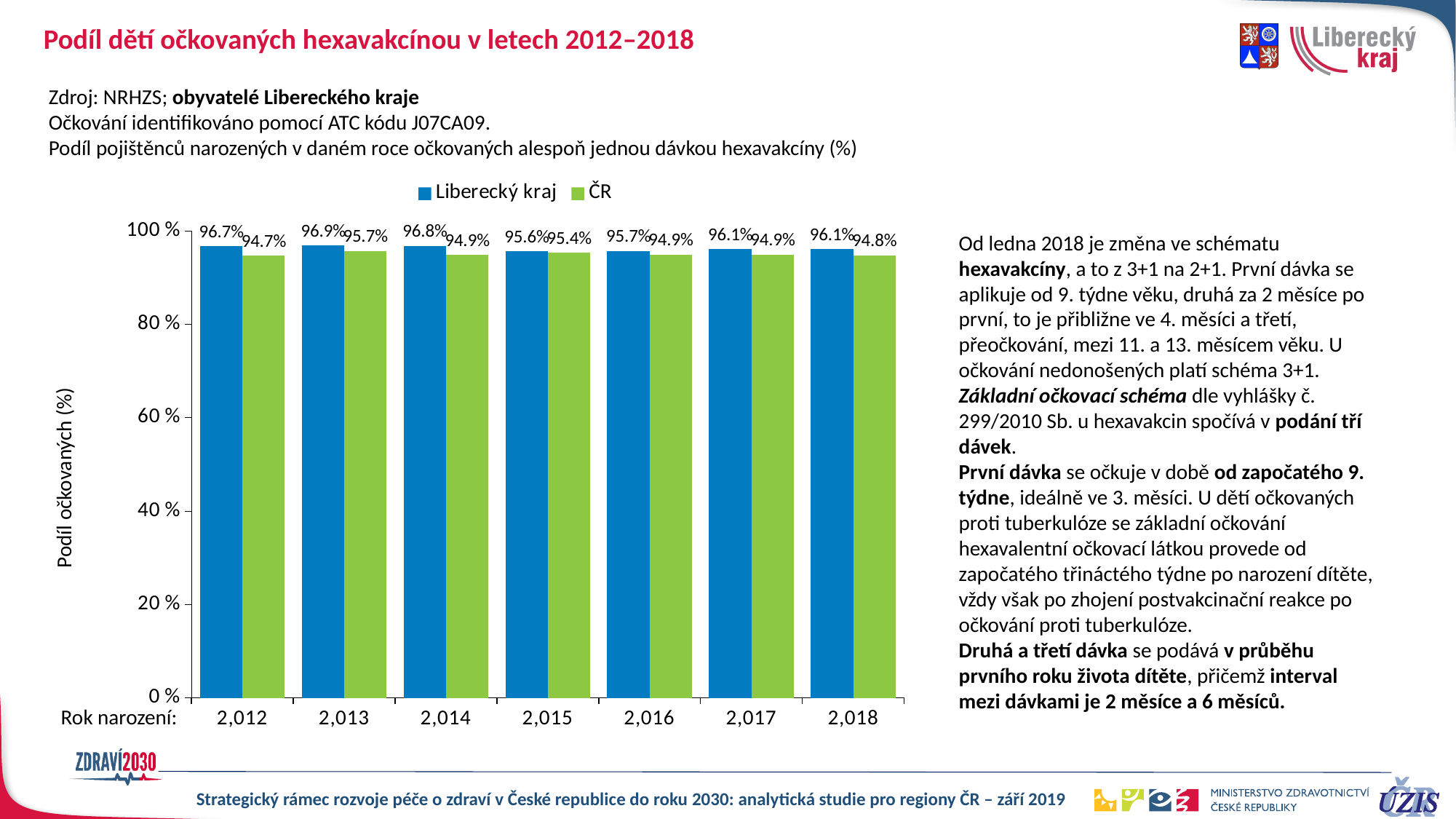
What is the difference between the Liberecký kraj and ČR values for birth year 2012? 2.0 percentage points What kind of chart is shown on the slide? bar chart For birth year 2014, which is larger: Liberecký kraj or ČR? Liberecký kraj How many birth years (categories) are shown on the x axis? 7 How many series does the legend list? 2 What is the value for Liberecký kraj for birth year 2012? 96.7% Which colour represents the ČR series in the chart? green In which birth year is the Liberecký kraj value lowest? 2015 What is the value for ČR for birth year 2013? 95.7% In which birth year is the ČR value lowest? 2012 What is the value for Liberecký kraj for birth year 2018? 96.1% In which birth year is the Liberecký kraj value highest? 2013